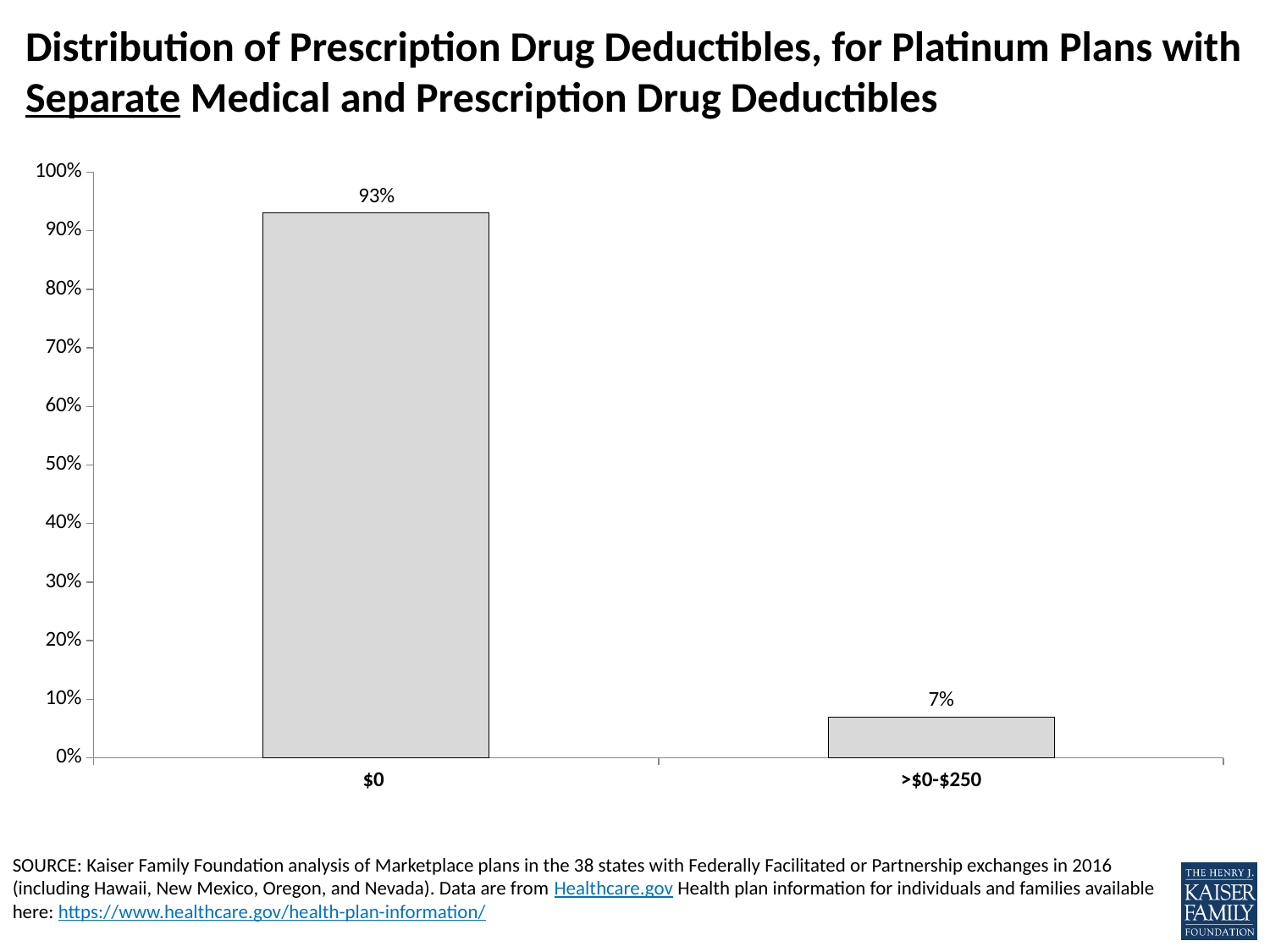
What is the total of the two percentages shown on the chart? 100% What percentage of plans fall in the >$0-$250 prescription drug deductible category? 7% What is the difference in percentage points between the $0 category and the >$0-$250 category? 86 percentage points Which category has a larger share of plans, $0 or >$0-$250? $0 Which deductible category has the lowest share of plans? >$0-$250 What percentage of platinum plans with separate deductibles have a $0 prescription drug deductible? 93% Is the value for the $0 category greater or less than 90%? greater What is the maximum value shown on the vertical axis of the chart? 100% What kind of chart is shown on the slide? Bar chart Is the value for the >$0-$250 category greater or less than 10%? less Which deductible category has the highest share of plans? $0 How many deductible categories are shown on the chart? 2